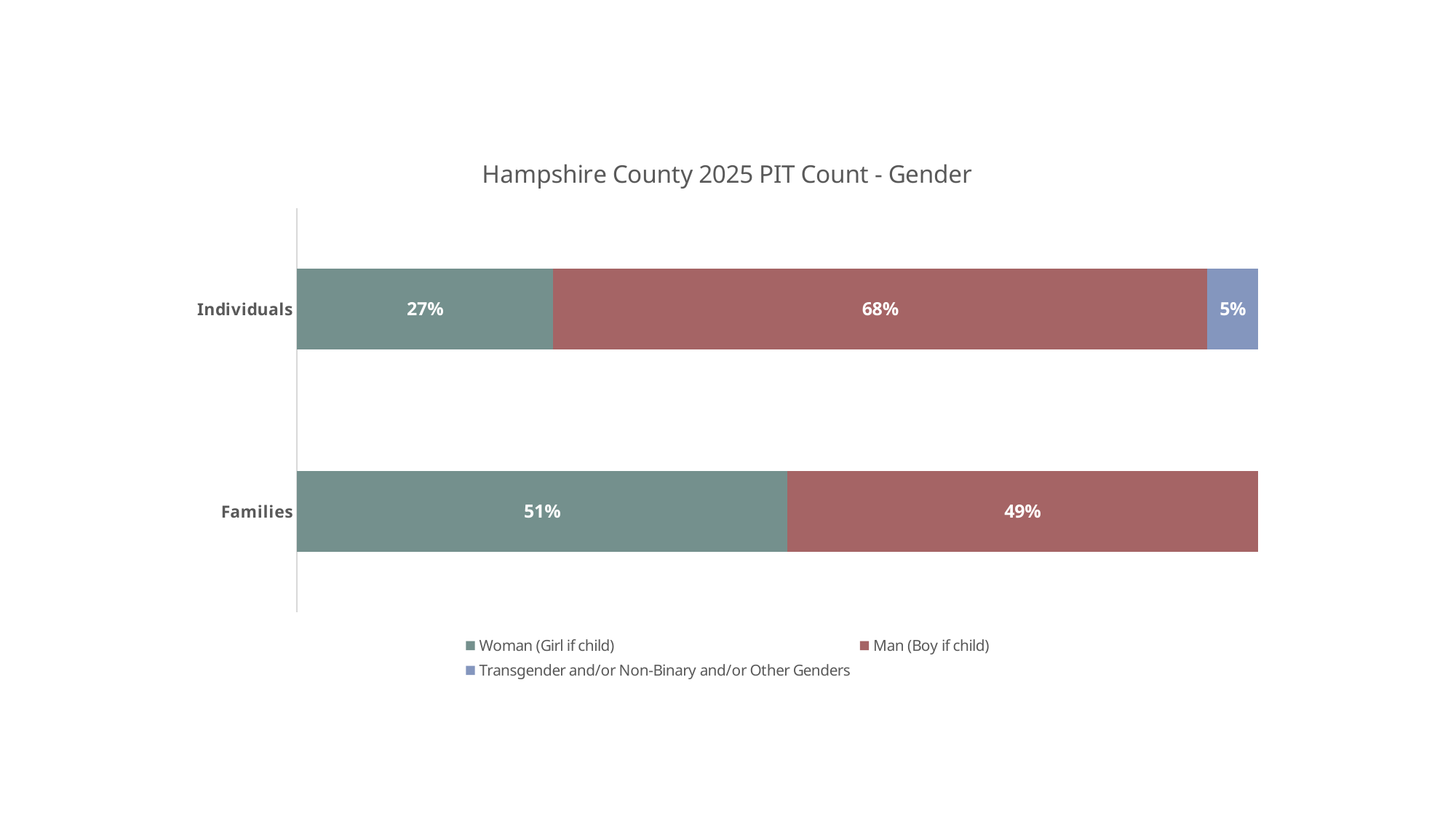
What is the value for Man (Boy if child) in the Families bar? 49% Which gender series has the smallest share in the Individuals bar? Transgender and/or Non-Binary and/or Other Genders What is the value for Woman (Girl if child) in the Individuals bar? 27% What kind of chart is this? Stacked bar chart What is the value for Transgender and/or Non-Binary and/or Other Genders in the Individuals bar? 5% Which is larger: the Woman (Girl if child) value for Individuals or for Families? Families What is the difference between the Man (Boy if child) and Woman (Girl if child) values in the Individuals bar? 41% How many series does the legend list? 3 How many categories are shown on the vertical axis? 2 What is the value for Man (Boy if child) in the Individuals bar? 68% What is the value for Woman (Girl if child) in the Families bar? 51% Which gender series has the largest share in the Individuals bar? Man (Boy if child)